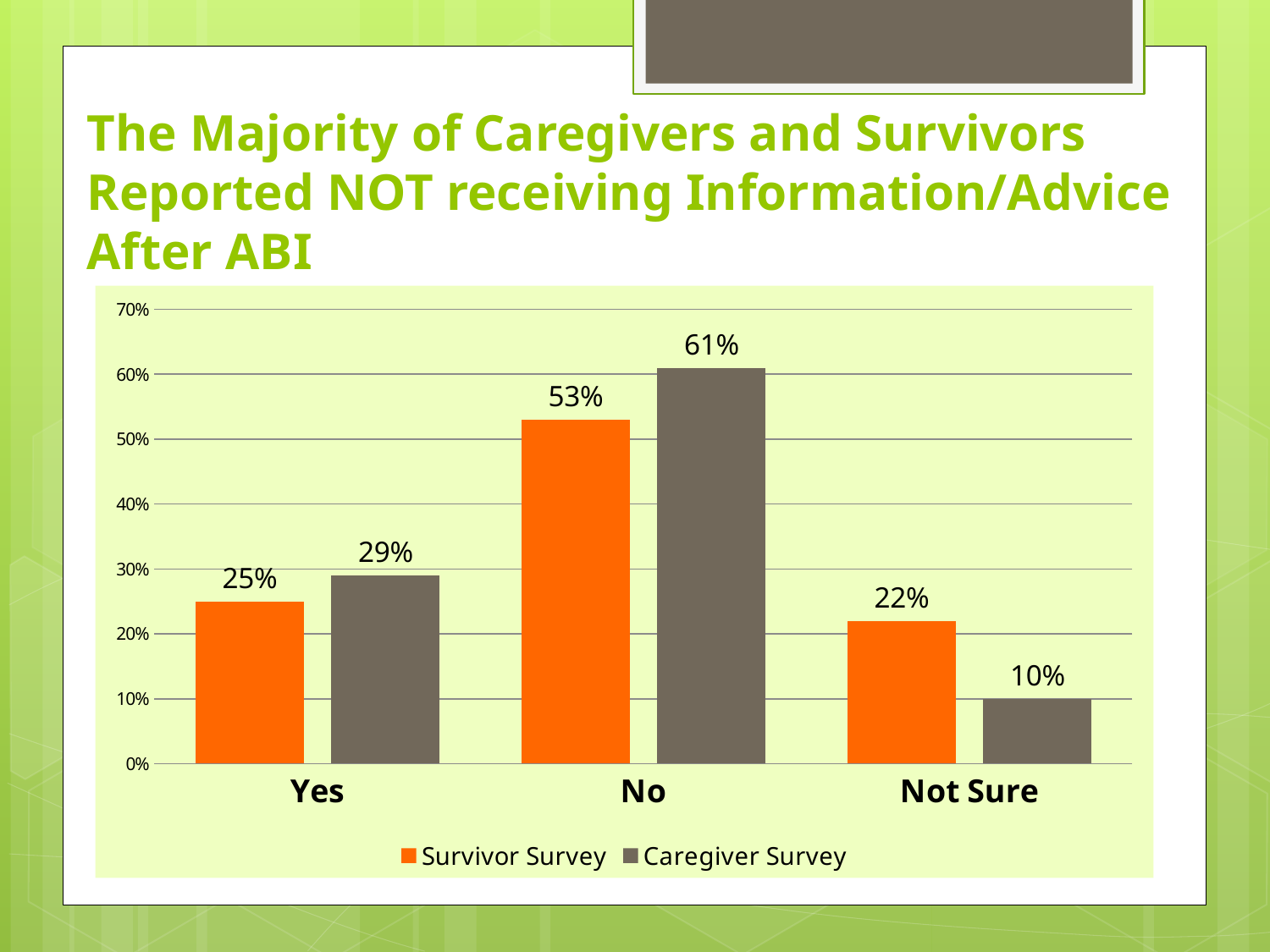
What is the Caregiver Survey value for "Yes"? 29% Which response category has the lowest value in the Survivor Survey? Not Sure Is the Survivor Survey value for "Yes" greater or less than 30%? less Which response category has the highest value in the Caregiver Survey? No Which colour represents the Caregiver Survey in the chart? Grey For "Not Sure", which survey has the larger value, Survivor Survey or Caregiver Survey? Survivor Survey What percentage of the Survivor Survey respondents answered "No"? 53% What kind of chart is shown on the slide? Bar chart How many series does the legend list? 2 What percentage of the Caregiver Survey respondents answered "Not Sure"? 10% How many response categories are shown on the x axis? 3 What is the difference between the Caregiver Survey and Survivor Survey values for "No"? 8%